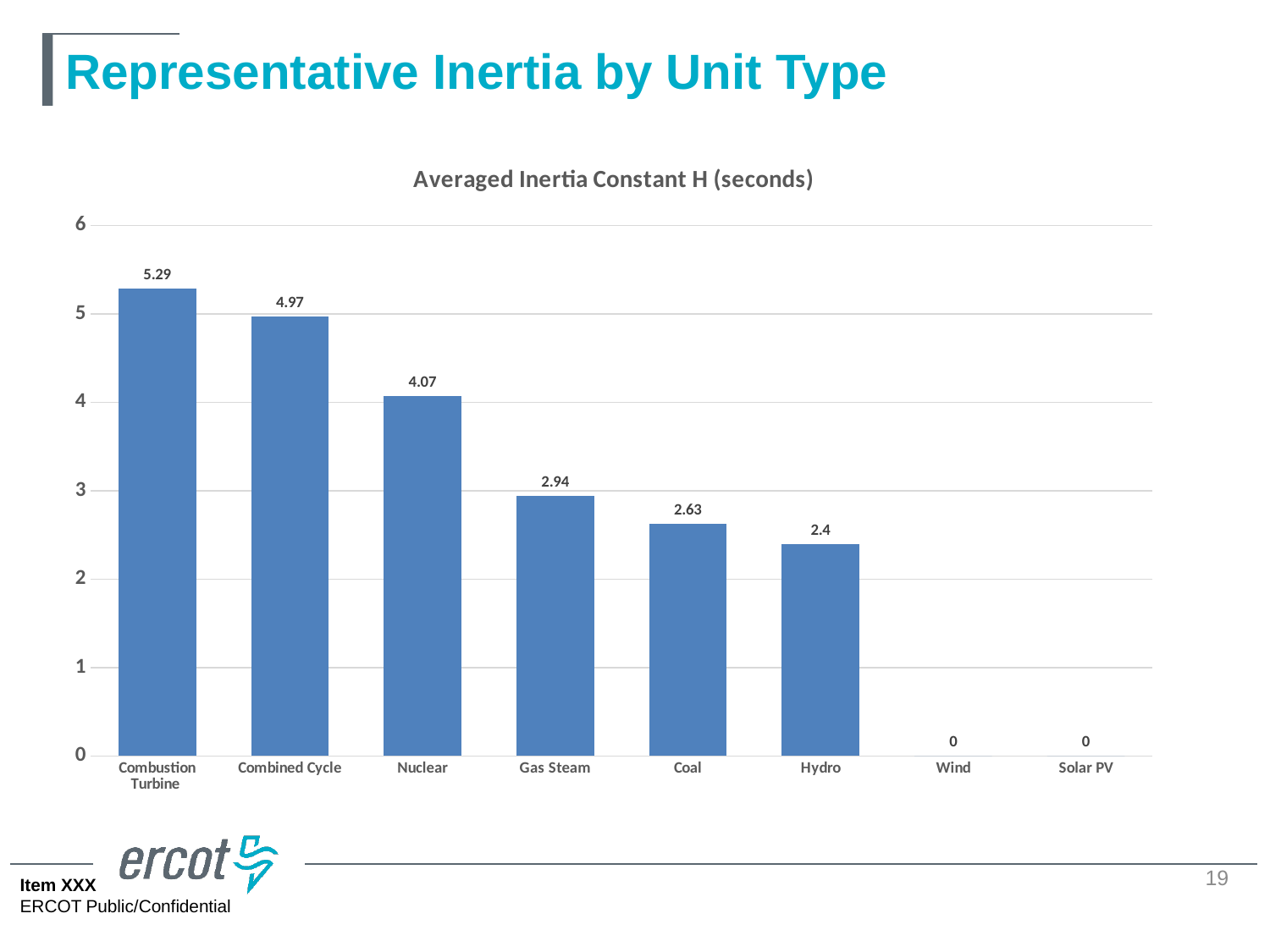
Which has a larger averaged inertia constant H, Nuclear or Gas Steam? Nuclear What is the difference between the averaged inertia constant H for Gas Steam and Coal? 0.31 What is the averaged inertia constant H for Combustion Turbine? 5.29 What is the averaged inertia constant H for Hydro? 2.4 What is the averaged inertia constant H for Nuclear? 4.07 What is the title of the chart? Averaged Inertia Constant H (seconds) What is the difference between the averaged inertia constant H for Combustion Turbine and Combined Cycle? 0.32 Which unit type has the highest averaged inertia constant H? Combustion Turbine Which unit types have an averaged inertia constant H of 0? Wind and Solar PV How many unit types are shown on the x axis? 8 What kind of chart is shown on the slide? Bar chart Is the value for Coal greater or less than 3? less